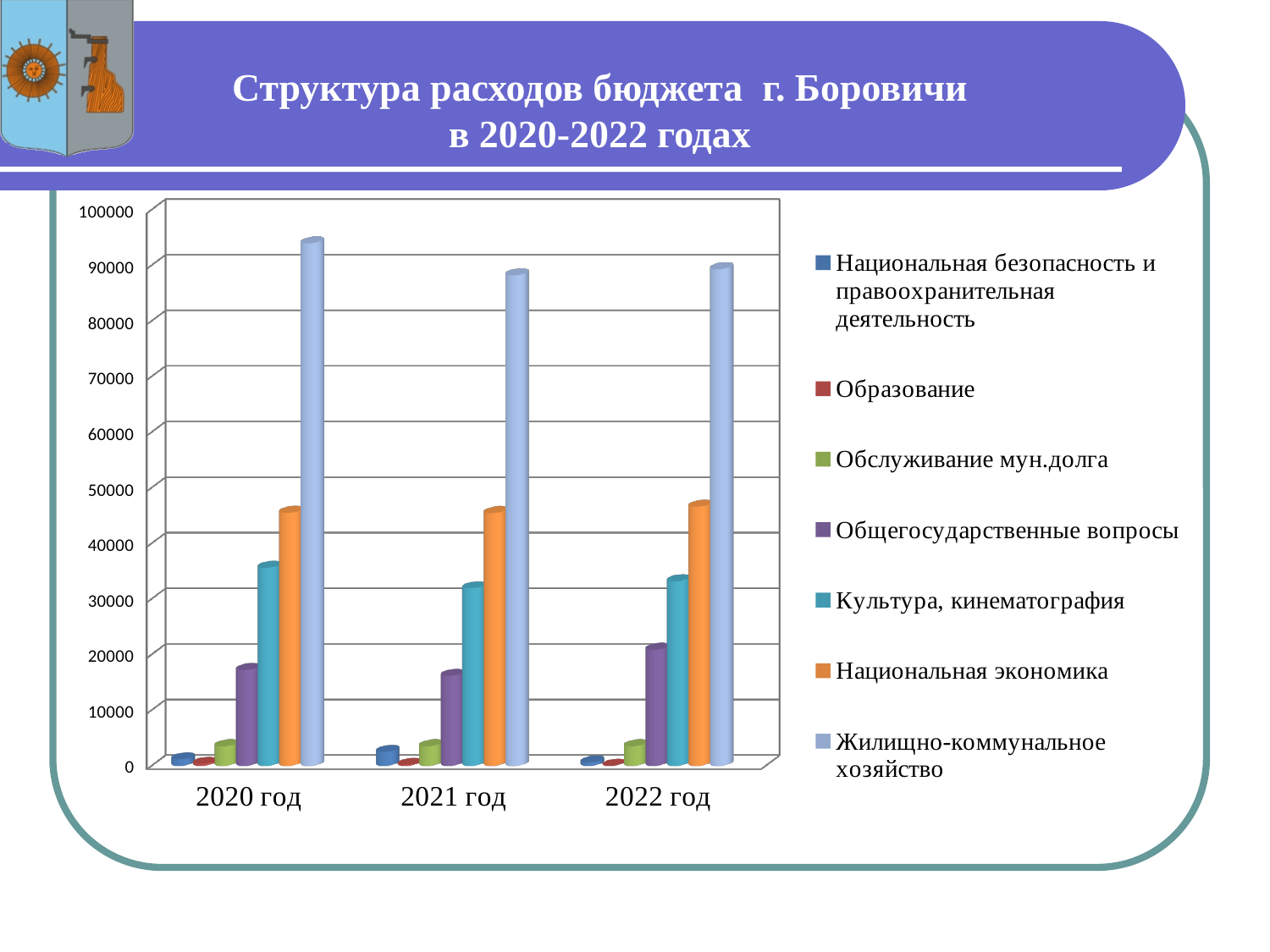
Is the value for Общегосударственные вопросы in 2020 год greater or less than 20000? less What kind of chart is shown on the slide? Bar chart Is the value for Национальная экономика in 2022 год greater or less than 40000? greater What is the title of the chart slide? Структура расходов бюджета г. Боровичи в 2020-2022 годах Is the value for Жилищно-коммунальное хозяйство in 2021 год greater or less than 90000? less Which series has the lowest value in 2021 год? Образование Which is larger: Культура, кинематография in 2020 год or in 2021 год? 2020 год How many year categories are shown on the x axis of the chart? 3 How many series does the chart legend list? 7 Which is larger: Общегосударственные вопросы in 2022 год or in 2020 год? 2022 год Which series has the highest value in 2020 год? Жилищно-коммунальное хозяйство